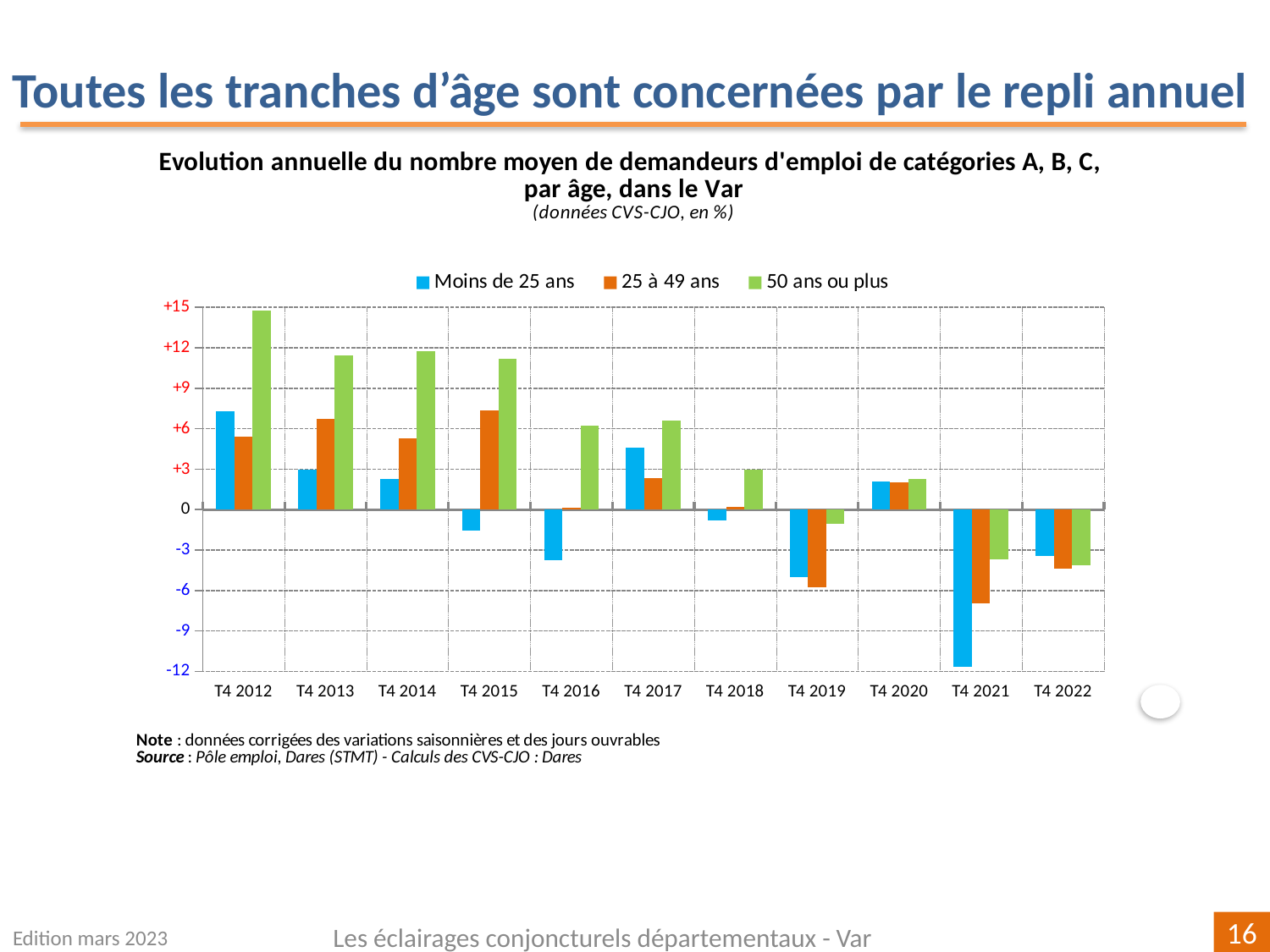
How many quarters (categories) are shown on the x axis? 11 Is the value for '25 à 49 ans' in T4 2021 greater or less than -6? less What colour represents the series '50 ans ou plus' in the legend? green For the series 'Moins de 25 ans', which quarter has the lowest value? T4 2021 For the series '50 ans ou plus', which quarter has the highest value? T4 2012 Do the values for 'Moins de 25 ans' rise or fall from T4 2012 to T4 2016? fall Is the value for 'Moins de 25 ans' in T4 2021 greater or less than -9? less What kind of chart is shown on the slide? bar chart In T4 2017, which series has the larger value: 'Moins de 25 ans' or '25 à 49 ans'? Moins de 25 ans How many series does the legend list? 3 In T4 2015, which series has the larger value: 'Moins de 25 ans' or '25 à 49 ans'? 25 à 49 ans Is the value for '50 ans ou plus' in T4 2012 greater or less than +12? greater